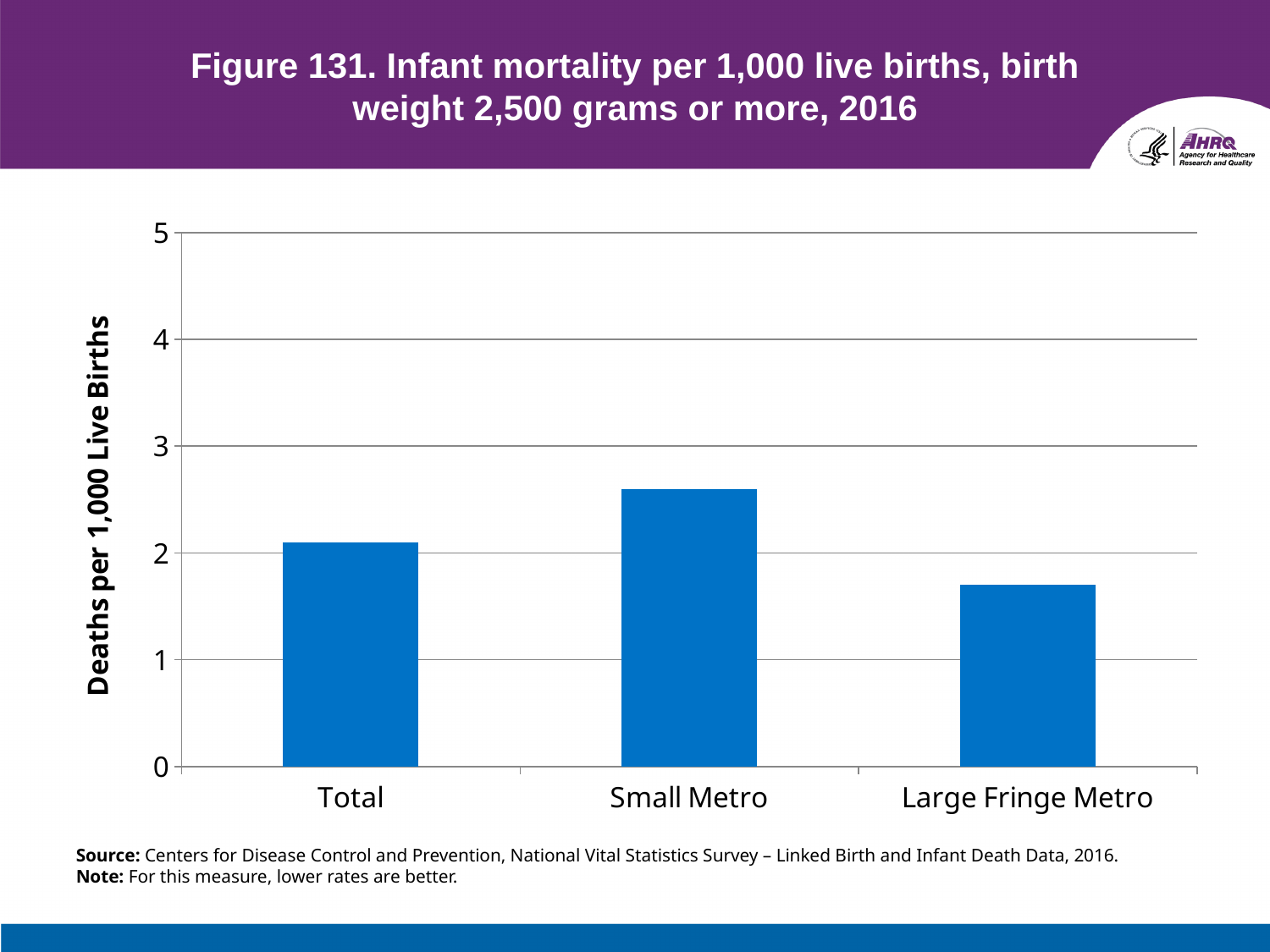
Which category has the lowest infant mortality rate? Large Fringe Metro Is the value for Large Fringe Metro greater or less than 1? greater How many categories are plotted on the chart? 3 Is the value for Total greater or less than 3? less Is the value for Small Metro greater or less than 3? less What is the label of the y axis? Deaths per 1,000 Live Births What kind of chart is shown on the slide? bar chart Which is larger, the value for Small Metro or the value for Total? Small Metro Which category has the highest infant mortality rate? Small Metro Which is larger, the value for Total or the value for Large Fringe Metro? Total